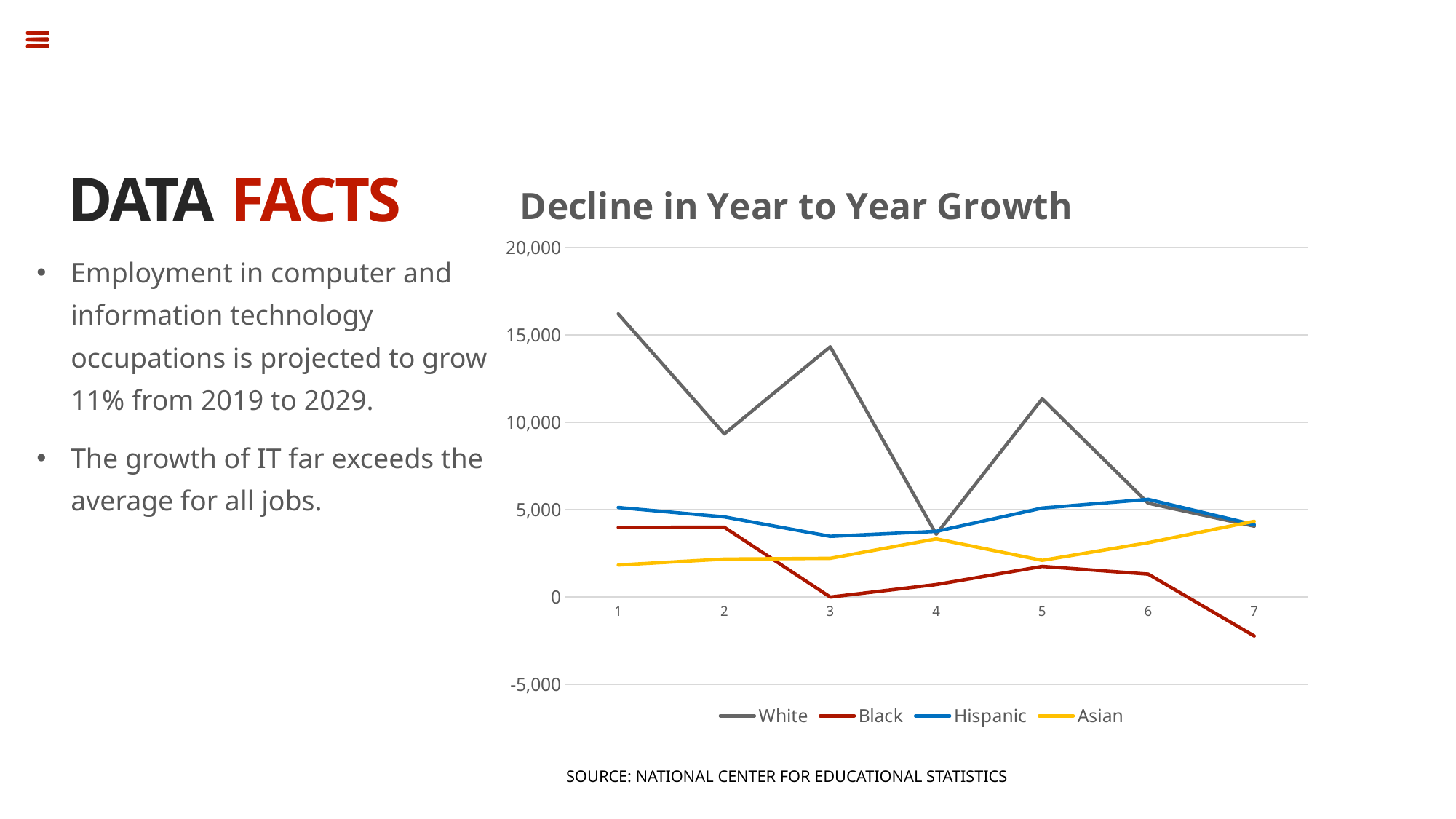
At point 3, which is larger, the value for White or the value for Hispanic? White Which series has the highest value at point 1? White Is the value for Black at point 7 greater or less than 0? less Is the value for White at point 2 greater or less than 10,000? less Does the Black series rise or fall from point 5 to point 7? Fall How many points are plotted along the x axis for each series? 7 Which colour is used for the Asian series in the legend? Yellow What is the title of the chart? Decline in Year to Year Growth What kind of chart is shown on the slide? Line chart Which series has the lowest value at point 7? Black How many series does the legend list? 4 Is the value for White at point 1 greater or less than 15,000? greater